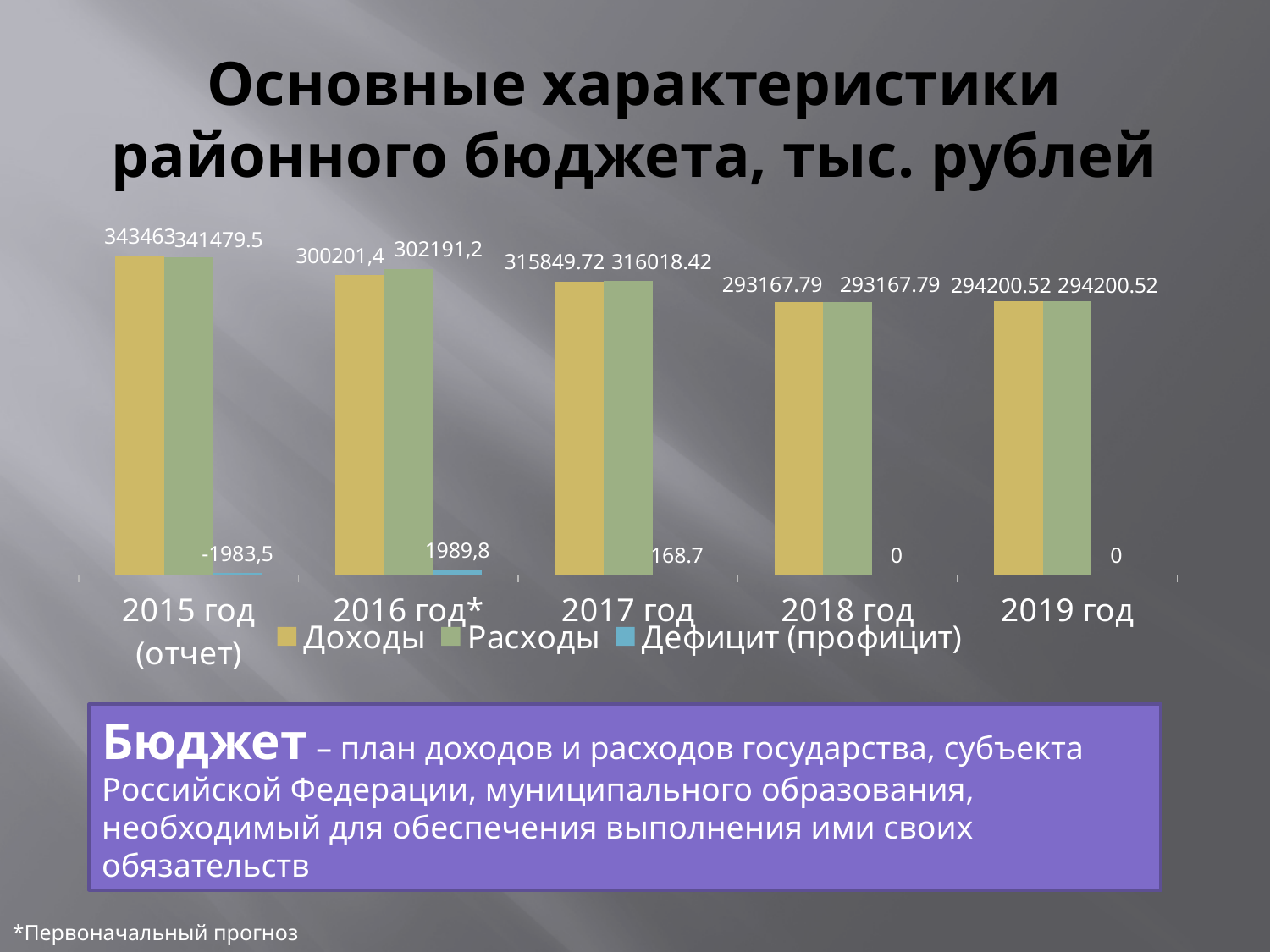
What is the value of Дефицит (профицит) for 2015 год (отчет)? -1983,5 What is the value of Дефицит (профицит) for 2017 год? 168.7 What is the value of Расходы for 2016 год*? 302191,2 Which year has the lowest value of Расходы? 2018 год What kind of chart is shown on the slide? bar chart How many series does the legend list? 3 What is the difference between Расходы and Доходы for 2017 год? 168.7 What is the value of Расходы for 2019 год? 294200.52 How many years are shown on the x axis? 5 Which is larger for 2016 год*: Доходы or Расходы? Расходы What is the value of Доходы for 2015 год (отчет)? 343463 Which year has the highest value of Доходы? 2015 год (отчет)